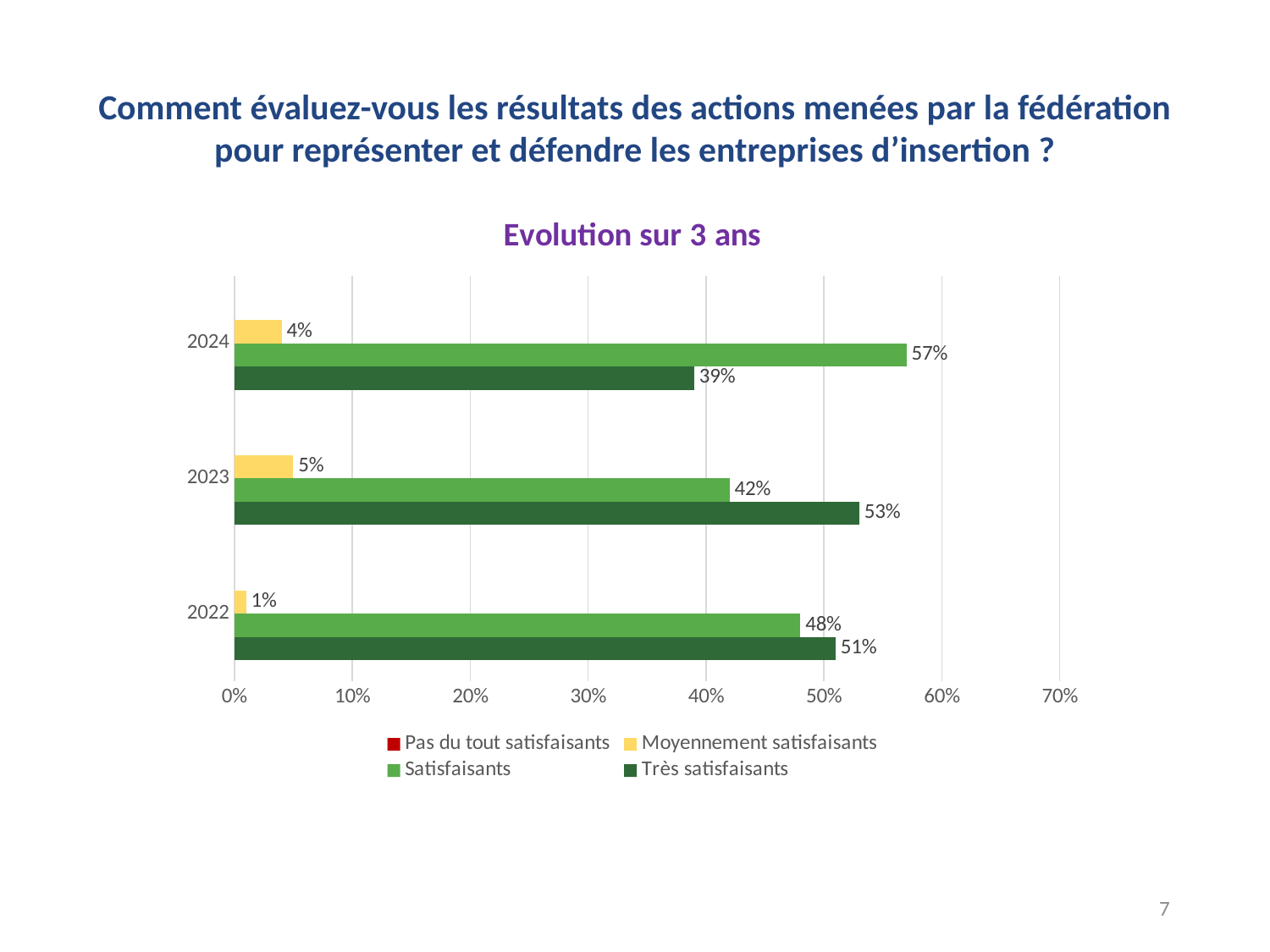
Does the value for "Très satisfaisants" rise or fall from 2023 to 2024? Fall What is the title of the chart? Evolution sur 3 ans How many series does the legend list? 4 What is the difference between the "Très satisfaisants" values for 2023 and 2024? 14% How many years are shown on the chart? 3 Which year has the highest value for "Satisfaisants"? 2024 In 2022, which is larger: "Satisfaisants" or "Très satisfaisants"? Très satisfaisants What is the value for "Très satisfaisants" in 2024? 39% What kind of chart is shown on the slide? Bar chart Which year has the lowest value for "Très satisfaisants"? 2024 What is the value for "Satisfaisants" in 2023? 42% What is the value for "Moyennement satisfaisants" in 2022? 1%